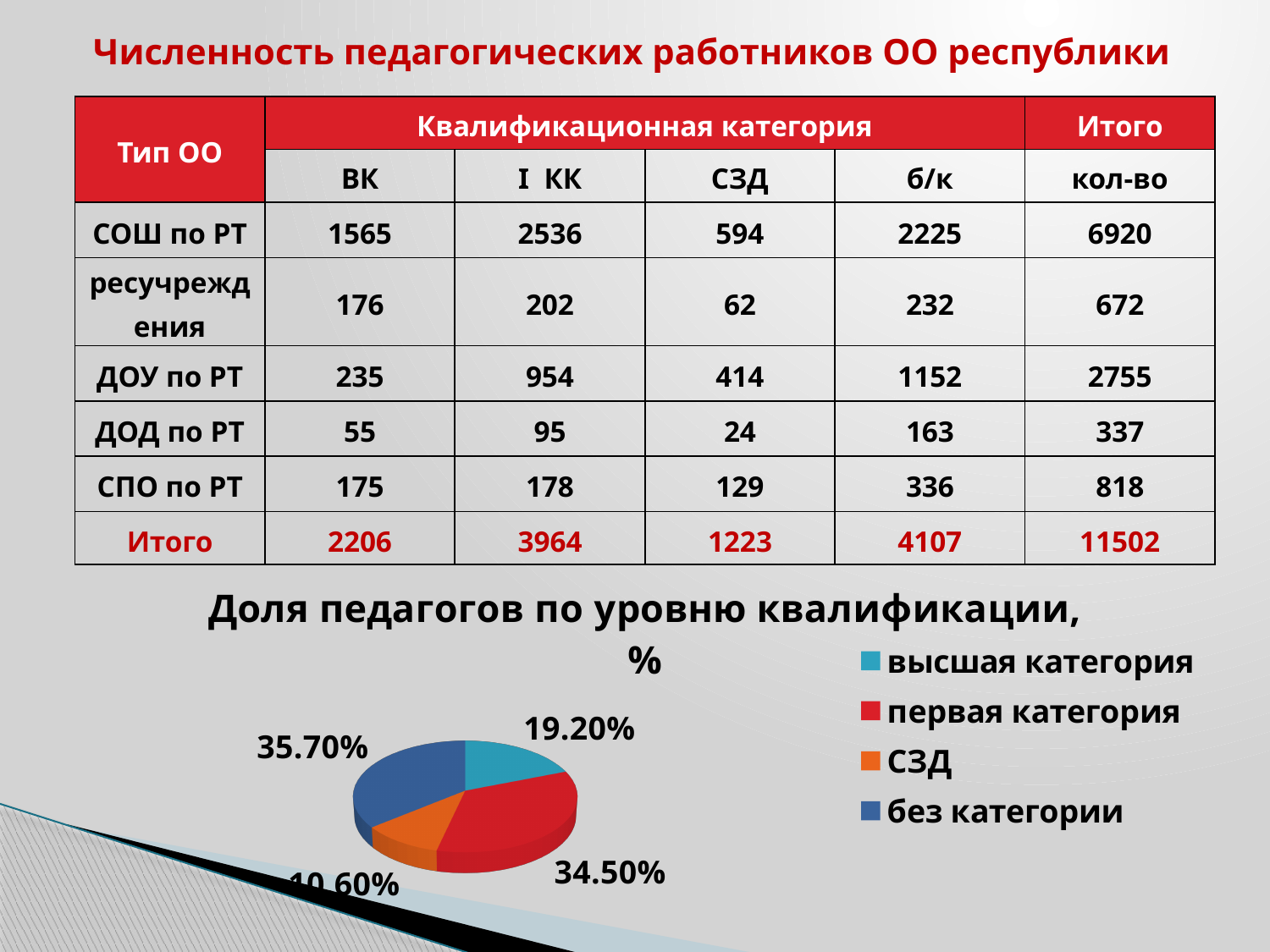
What kind of chart is shown on the slide? pie chart What is the title of the pie chart? Доля педагогов по уровню квалификации, % Which category has the smallest slice in the pie chart? СЗД Which category has the largest slice in the pie chart? без категории How many slices does the pie chart have? 4 What share of the pie chart is labelled for высшая категория? 19.20% What share of the pie chart is labelled for без категории? 35.70% What is the difference between the shares for без категории and высшая категория in the pie chart? 16.50% What share of the pie chart is labelled for первая категория? 34.50% What colour is the slice for первая категория in the pie chart? red Which is larger in the pie chart: the share for высшая категория or the share for первая категория? первая категория How many categories does the legend of the pie chart list? 4